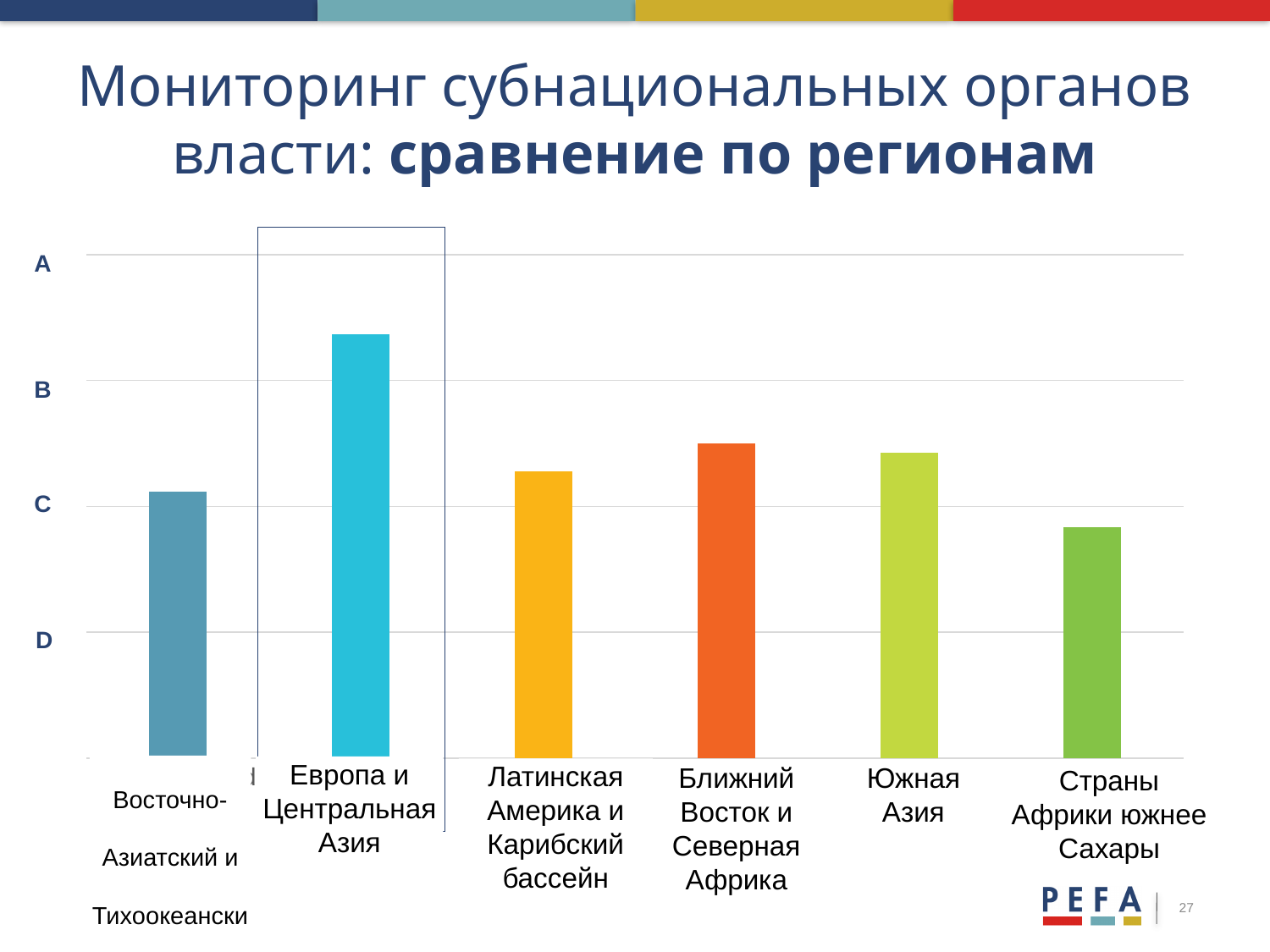
Which region's bar is outlined with a rectangular box on the chart? Европа и Центральная Азия What letter grades are marked on the vertical axis of the chart? A, B, C, D Is the bar for Страны Африки южнее Сахары above or below the gridline marked C? below What kind of chart is shown on the slide? Bar chart Which region has the lowest bar in the chart? Страны Африки южнее Сахары Which region has the highest bar in the chart? Европа и Центральная Азия Which bar is taller: Европа и Центральная Азия or Латинская Америка и Карибский бассейн? Европа и Центральная Азия Which bar is taller: Восточно-Азиатский и Тихоокеанский or Страны Африки южнее Сахары? Восточно-Азиатский и Тихоокеанский Is the bar for Ближний Восток и Северная Африка above or below the gridline marked B? below How many regions (bars) are shown in the chart? 6 Is the bar for Европа и Центральная Азия above or below the gridline marked B? above